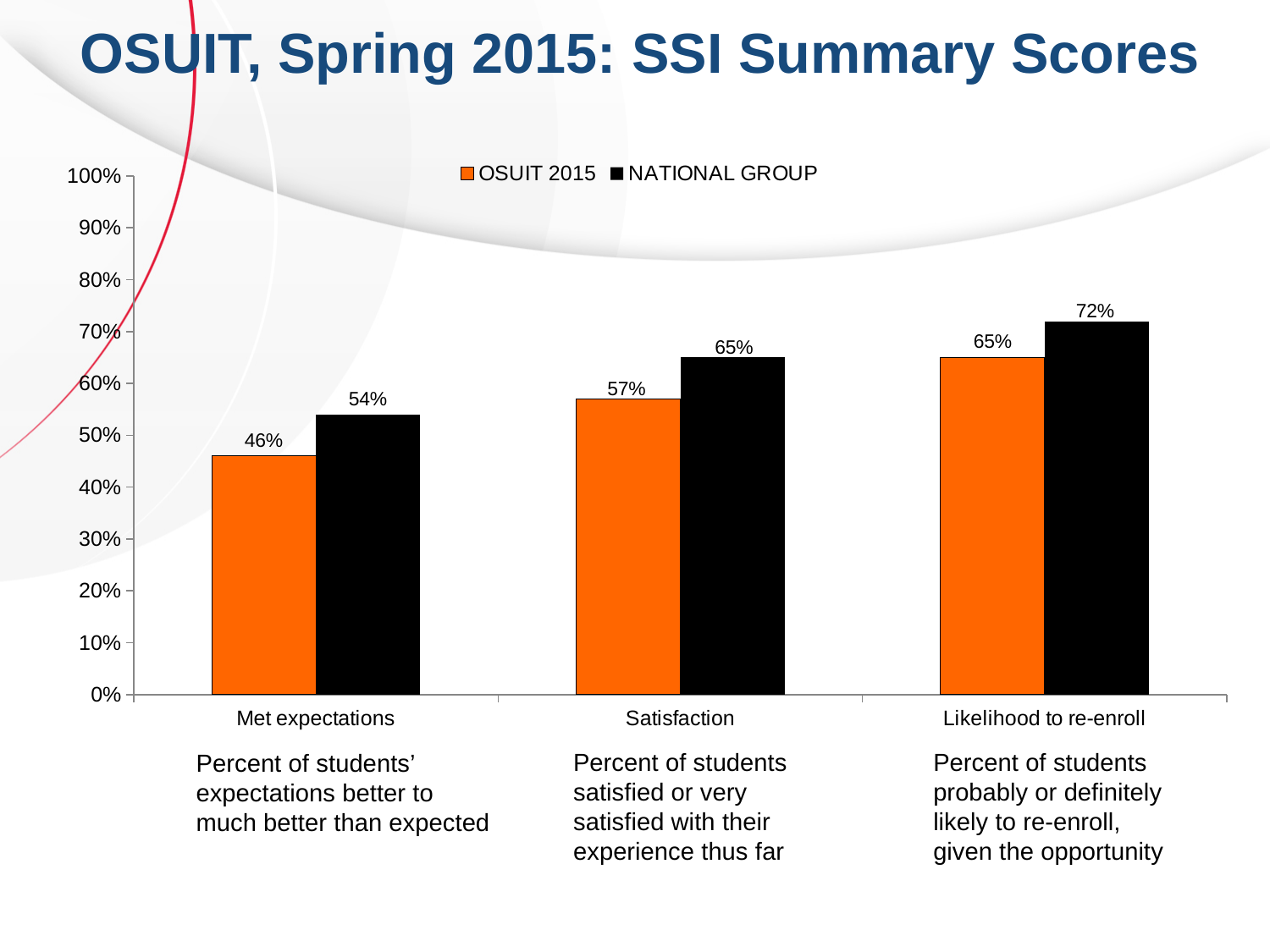
How many categories are shown on the x axis? 3 How many series does the legend list? 2 What is the OSUIT 2015 value for Met expectations? 46% What is the difference between the NATIONAL GROUP and OSUIT 2015 values for Met expectations? 8% What is the difference between the NATIONAL GROUP and OSUIT 2015 values for Satisfaction? 8% What kind of chart is shown on the slide? Bar chart What is the OSUIT 2015 value for Satisfaction? 57% Which is larger for Likelihood to re-enroll, the OSUIT 2015 value or the NATIONAL GROUP value? NATIONAL GROUP Which category has the highest NATIONAL GROUP value? Likelihood to re-enroll What is the NATIONAL GROUP value for Likelihood to re-enroll? 72% Which category has the lowest OSUIT 2015 value? Met expectations Do the OSUIT 2015 values rise or fall from Met expectations to Likelihood to re-enroll? Rise